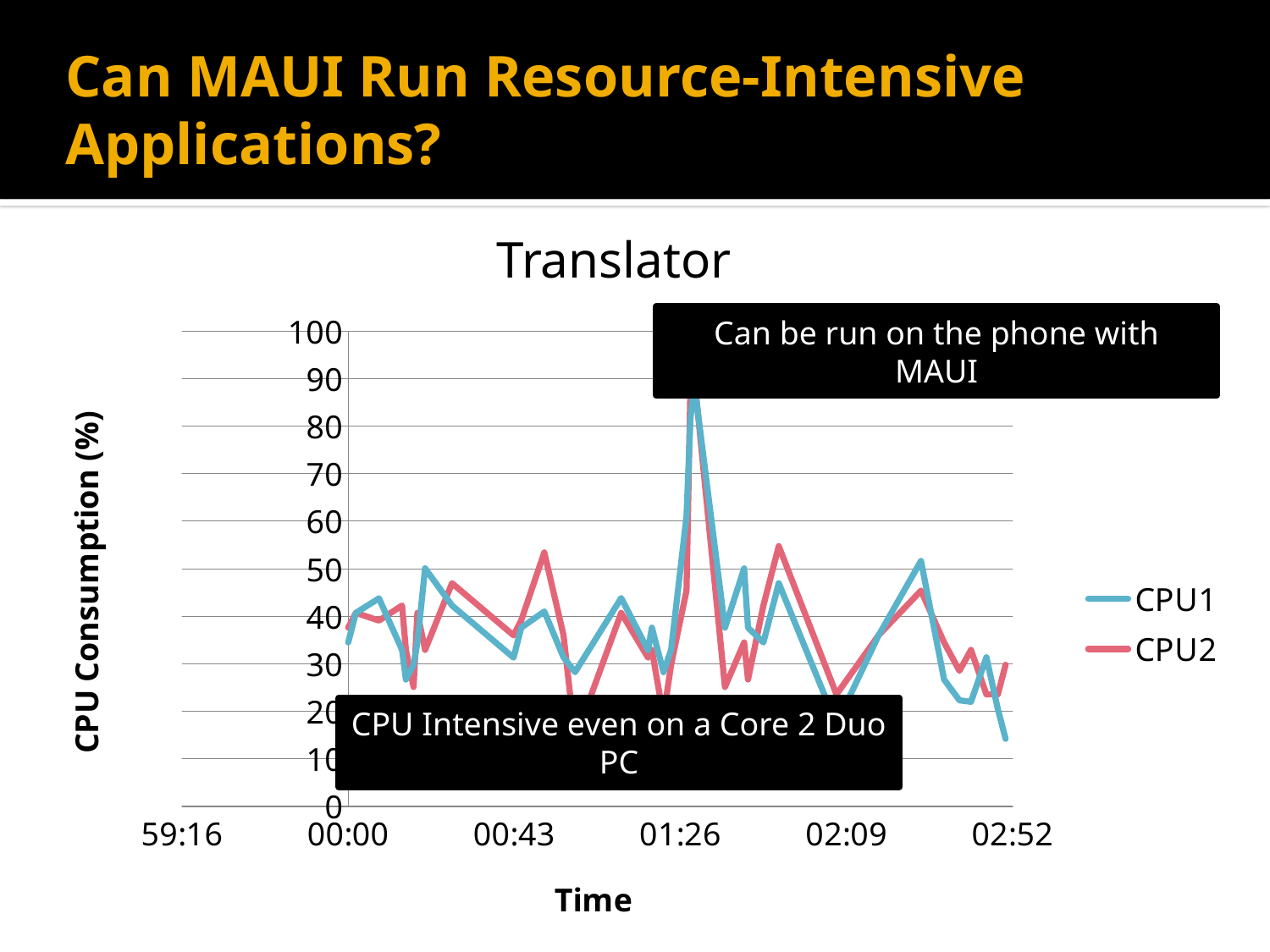
Is the highest value reached by CPU1 greater or less than 80? greater What kind of chart is shown on the slide? line chart At the last time point (near 02:52), which series has the larger value, CPU1 or CPU2? CPU2 How many time labels are shown along the horizontal axis? 6 What is the highest value shown on the vertical axis? 100 Is the value for CPU1 at the first time point (00:00) greater or less than 50? less What is the title of the chart? Translator How many series does the legend list? 2 What is the label of the vertical axis? CPU Consumption (%)